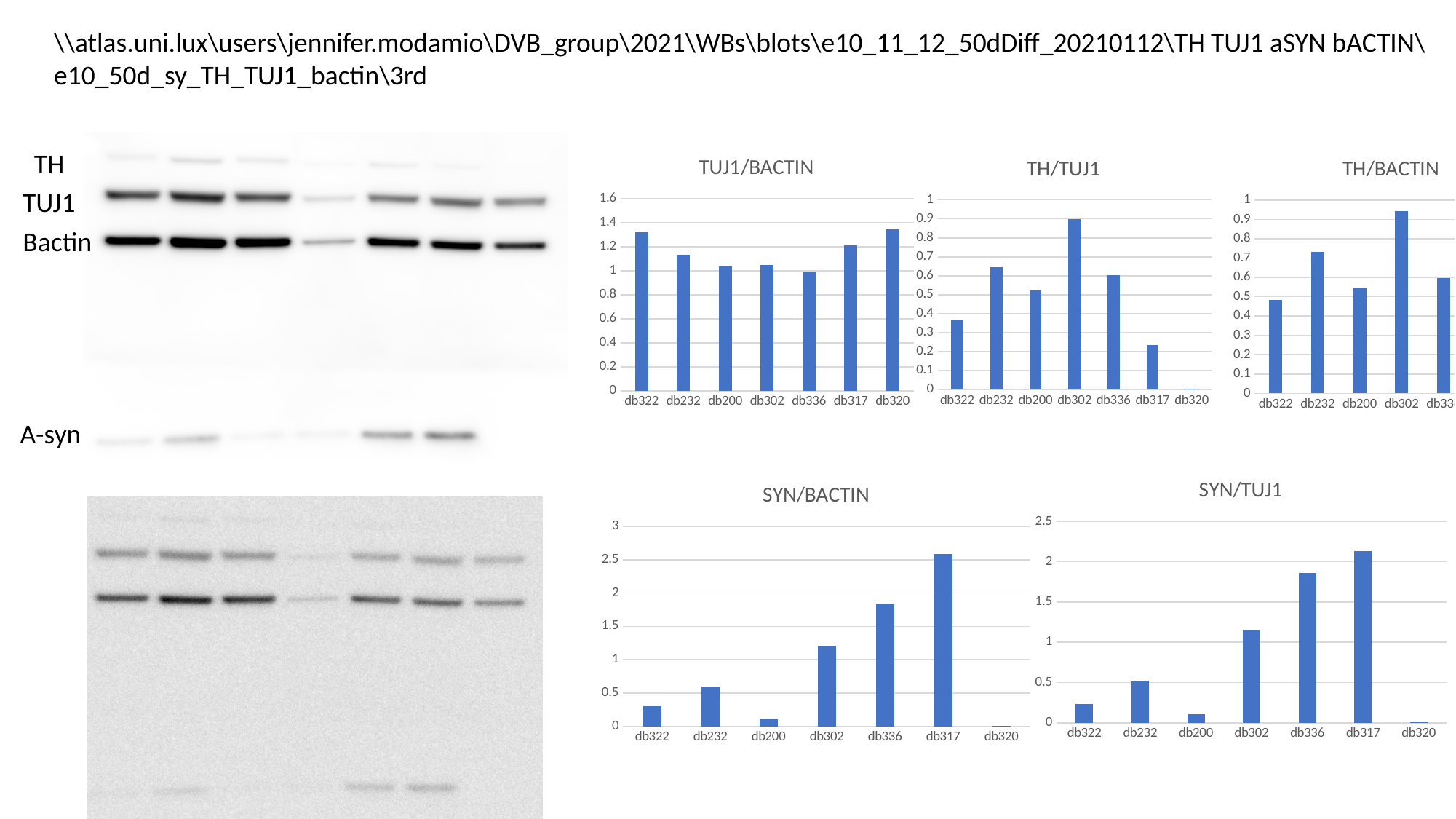
In the TH/TUJ1 chart, which is larger, the value for db232 or the value for db200? db232 In the TUJ1/BACTIN chart, is the value for db322 greater or less than 1.2? greater In the SYN/TUJ1 chart, is the value for db336 greater or less than 1.5? greater In the SYN/BACTIN chart, is the value for db336 greater or less than 2? less In the TH/TUJ1 chart, which category has the highest value? db302 In the SYN/BACTIN chart, which category has the highest value? db317 In the SYN/TUJ1 chart, which is larger, the value for db322 or the value for db232? db232 How many categories are shown on the x axis of the SYN/BACTIN chart? 7 In the TH/TUJ1 chart, which category has the lowest value? db320 What kind of chart is the SYN/BACTIN chart? bar chart In the TH/BACTIN chart, which category has the highest value? db302